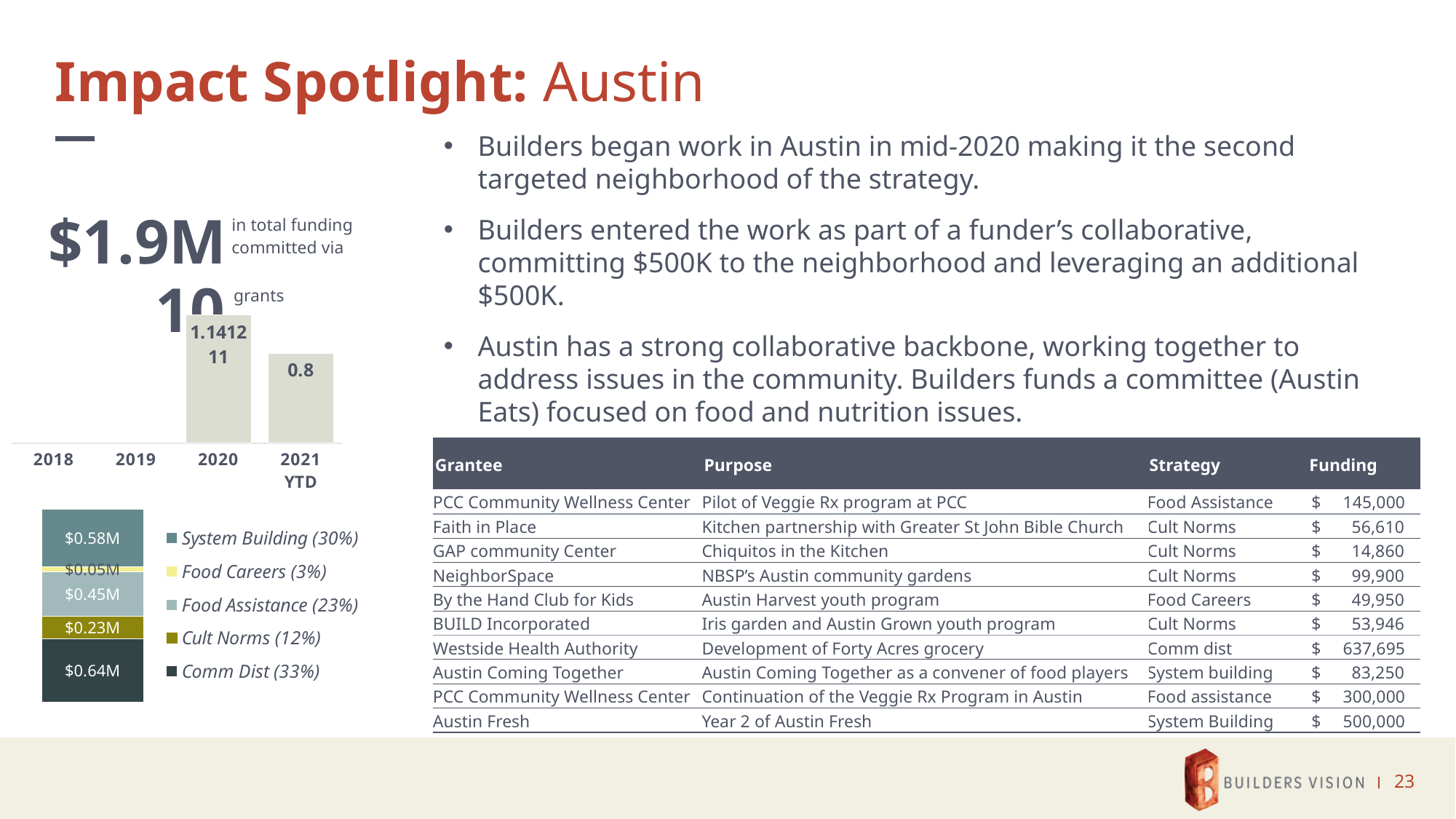
In the stacked bar chart at the bottom left, how many series does the legend list? 5 In the bar chart by year on the left, what value is shown for 2021 YTD? 0.8 In the bar chart by year on the left, how many year categories are shown on the x axis? 4 What kind of chart is the chart by year on the left of the slide? Bar chart In the stacked bar chart at the bottom left, what percentage share does the legend give for Food Assistance? 23% In the stacked bar chart at the bottom left, which segment has the largest value? Comm Dist In the bar chart by year on the left, is the value for 2020 larger or smaller than the value for 2021 YTD? Larger In the stacked bar chart at the bottom left, which segment has the smallest value? Food Careers In the stacked bar chart at the bottom left, what is the value for System Building? $0.58M In the stacked bar chart at the bottom left, what is the difference between the Comm Dist value and the System Building value? $0.06M In the bar chart by year on the left, which year has the highest bar? 2020 In the stacked bar chart at the bottom left, what is the value for Cult Norms? $0.23M